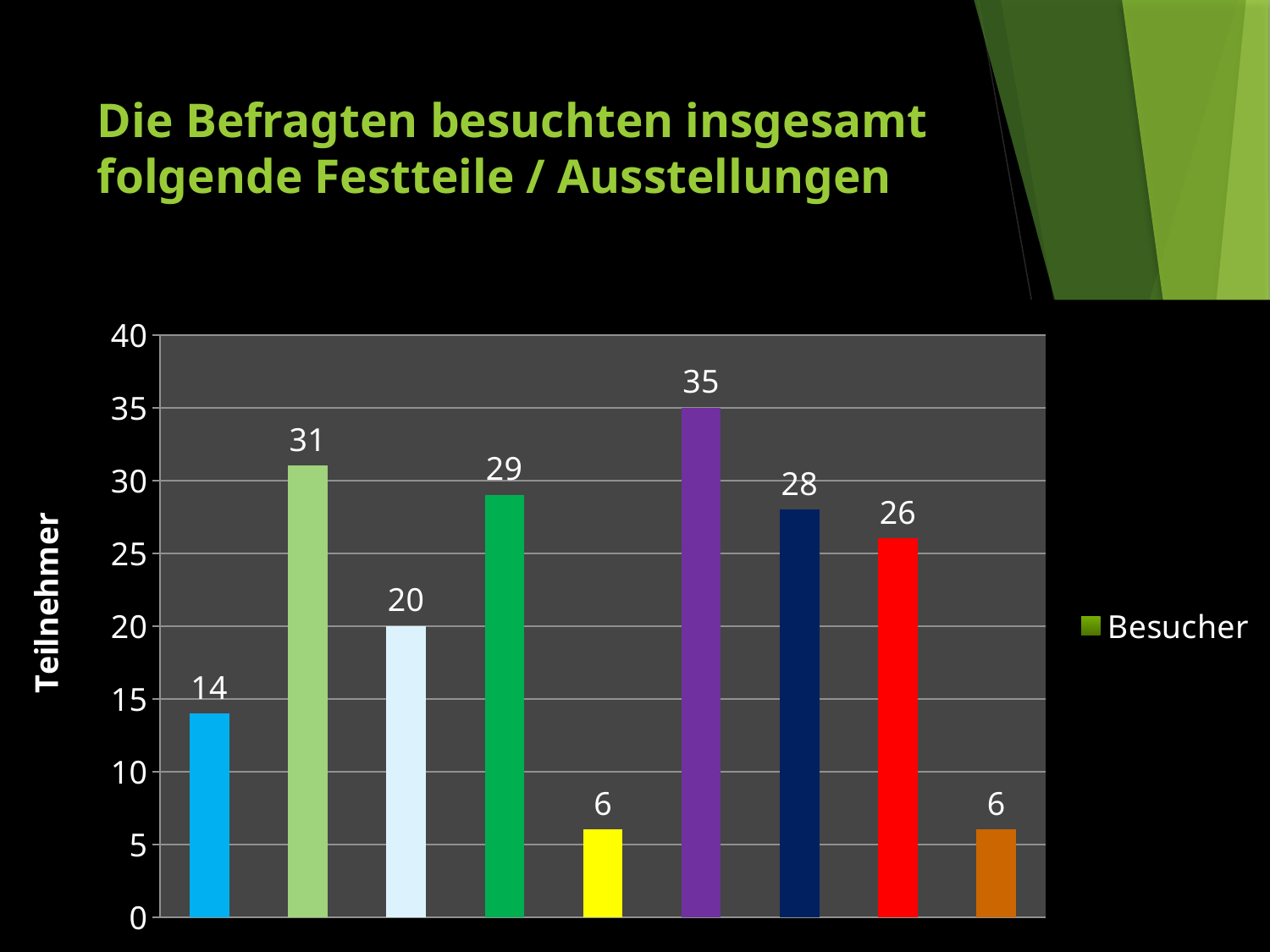
How many bars are plotted in the chart? 9 Which is larger, the light green bar or the green bar? the light green bar What is the difference between the purple bar (35) and the dark blue bar (28)? 7 What type of chart is shown on the slide? bar chart What is the value of the purple bar? 35 What is the lowest value shown in the chart? 6 How many series does the legend list? 1 What is the label on the vertical axis? Teilnehmer What is the value of the first (light blue) bar from the left? 14 What is the highest value shown in the chart? 35 What is the name of the series shown in the legend? Besucher What is the value of the red bar? 26